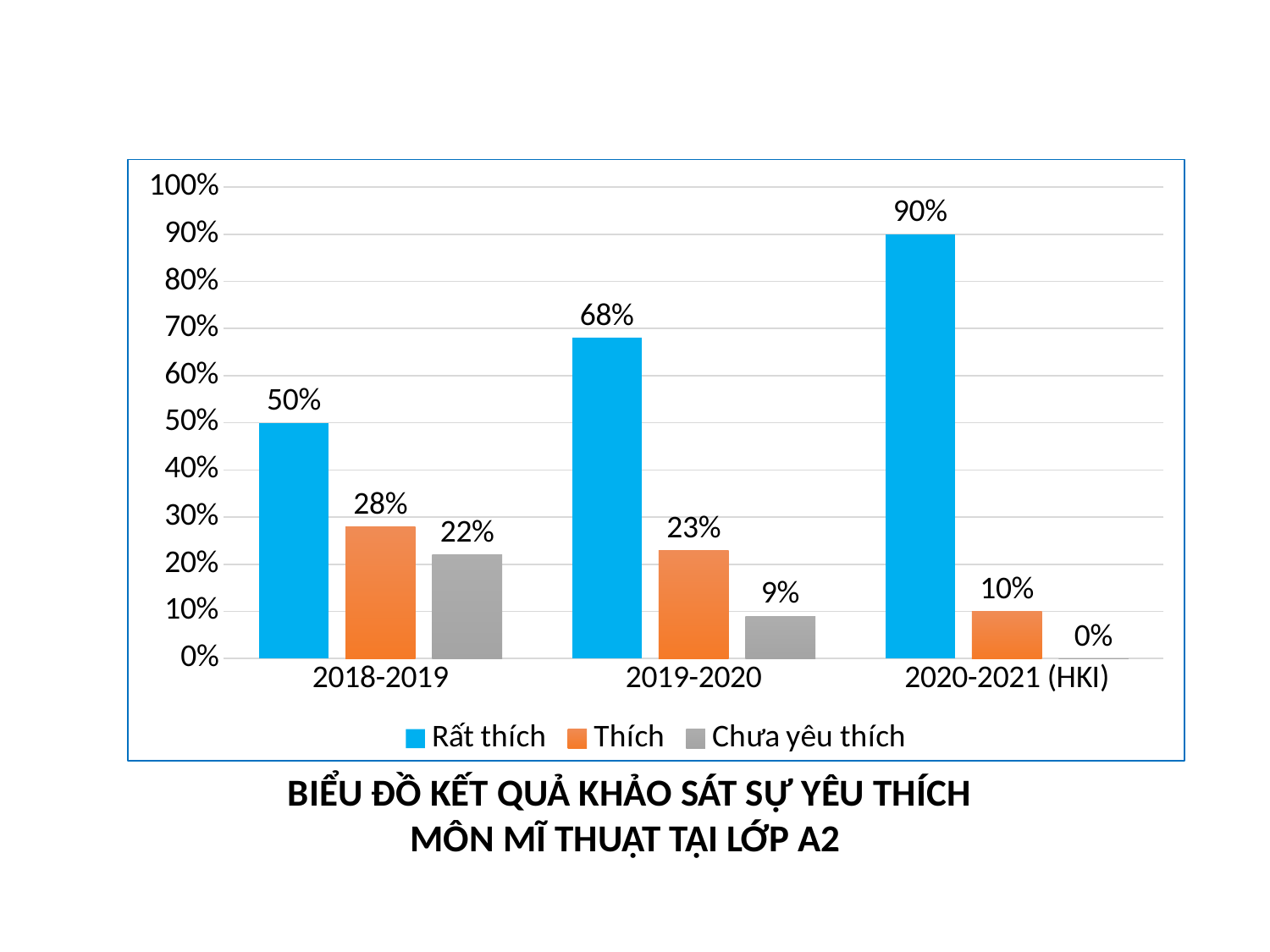
How many series does the legend list? 3 In which year group is the "Chưa yêu thích" value lowest? 2020-2021 (HKI) What is the value for "Thích" in 2019-2020? 23% What is the difference between the "Rất thích" values for 2020-2021 (HKI) and 2018-2019? 40% What kind of chart is shown on the slide? Bar chart How many year groups are shown on the x axis? 3 Does the "Rất thích" series rise or fall across the year groups from left to right? Rise What is the value for "Chưa yêu thích" in 2020-2021 (HKI)? 0% Which is larger: "Thích" in 2018-2019 or "Chưa yêu thích" in 2018-2019? Thích in 2018-2019 In which year group is the "Rất thích" value highest? 2020-2021 (HKI) Which colour represents the "Chưa yêu thích" series? Grey What is the value for "Rất thích" in 2018-2019? 50%